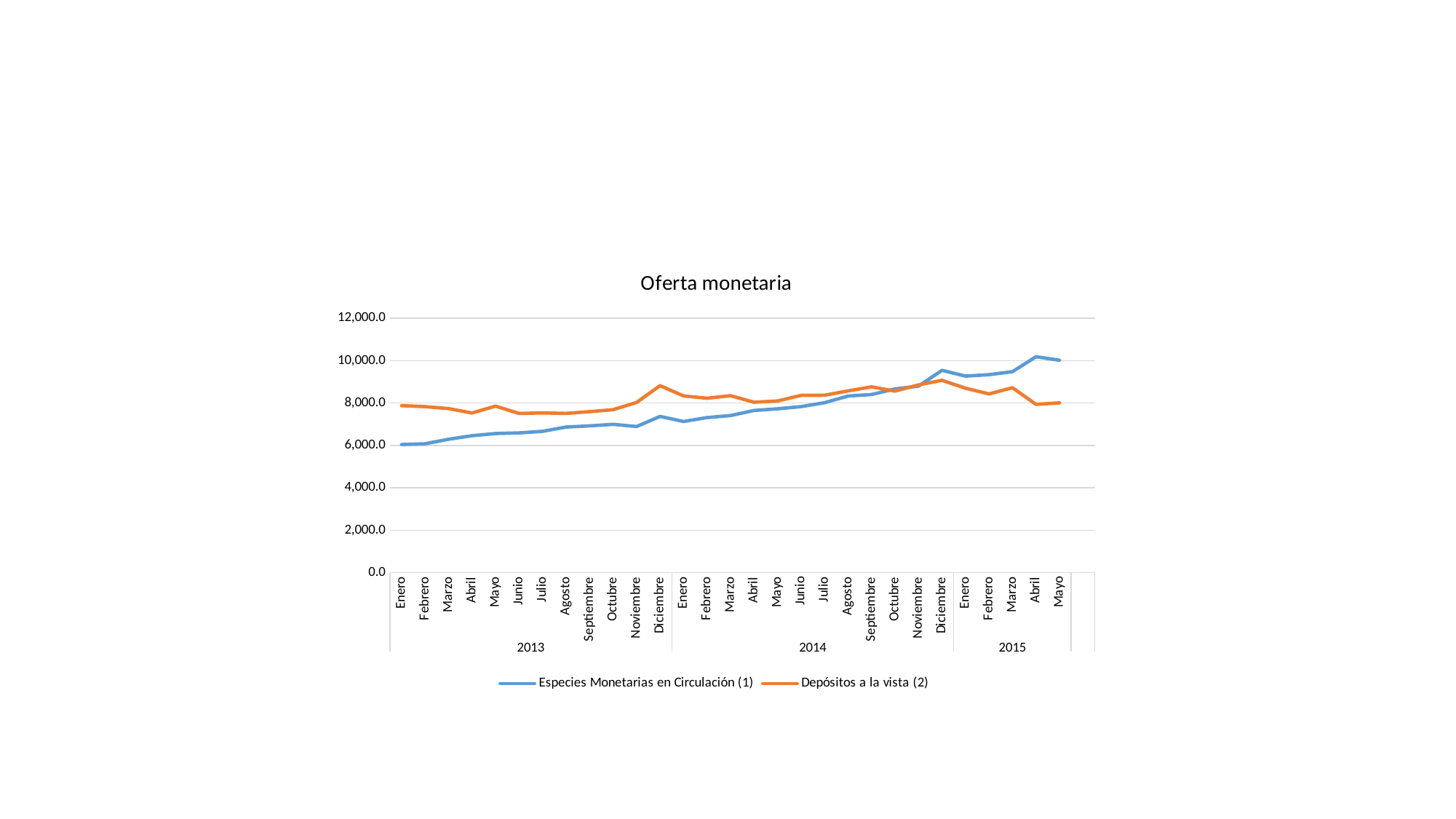
How many monthly data points are plotted along the x axis? 29 In which month is the Depósitos a la vista (2) series at its highest? Diciembre 2014 In which month is the Especies Monetarias en Circulación (1) series at its highest? Abril 2015 How many series does the legend list? 2 Which series is drawn in orange? Depósitos a la vista (2) Is the value for Especies Monetarias en Circulación (1) in Enero 2013 greater or less than 8,000.0? less What is the title of the chart? Oferta monetaria What kind of chart is shown on the slide? line chart Is the value for Depósitos a la vista (2) in Diciembre 2013 greater or less than 8,000.0? greater Does the Especies Monetarias en Circulación (1) series generally rise or fall from Enero 2013 to Mayo 2015? rise In Enero 2013, which series has the higher value? Depósitos a la vista (2) Is the value for Especies Monetarias en Circulación (1) in Abril 2015 greater or less than 10,000.0? greater